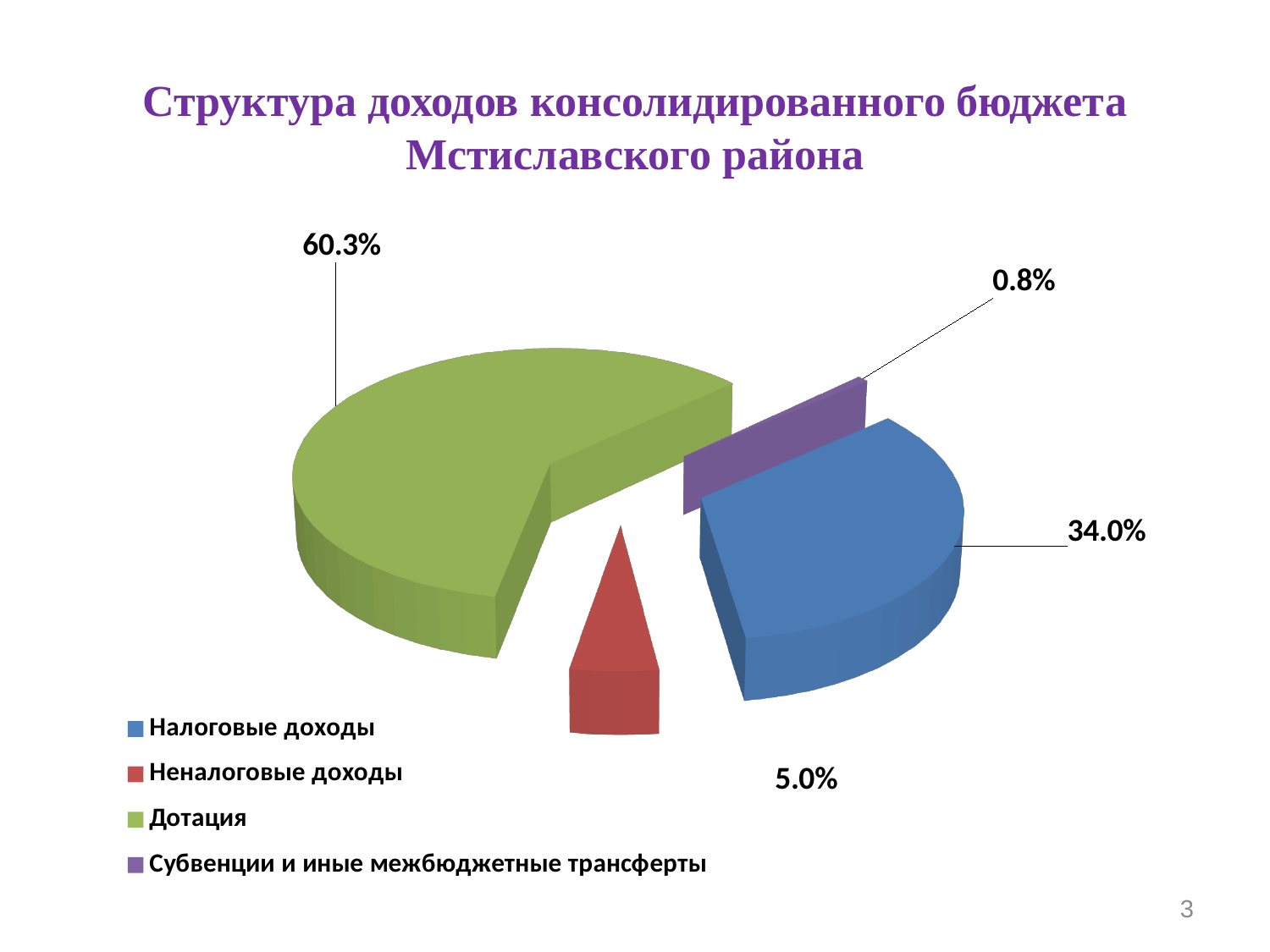
What is the value shown for Неналоговые доходы? 5.0% What is the value shown for Налоговые доходы? 34.0% What is the value shown for Субвенции и иные межбюджетные трансферты? 0.8% What is the title of the chart? Структура доходов консолидированного бюджета Мстиславского района What colour is the slice for Неналоговые доходы? Red What is the difference in percentage points between Дотация and Налоговые доходы? 26.3 Which is larger, Налоговые доходы or Неналоговые доходы? Налоговые доходы Which category has the smallest slice of the pie? Субвенции и иные межбюджетные трансферты What share of the pie does Дотация account for? 60.3% What kind of chart is shown on the slide? Pie chart How many categories does the pie chart show? 4 Which category has the largest slice of the pie? Дотация